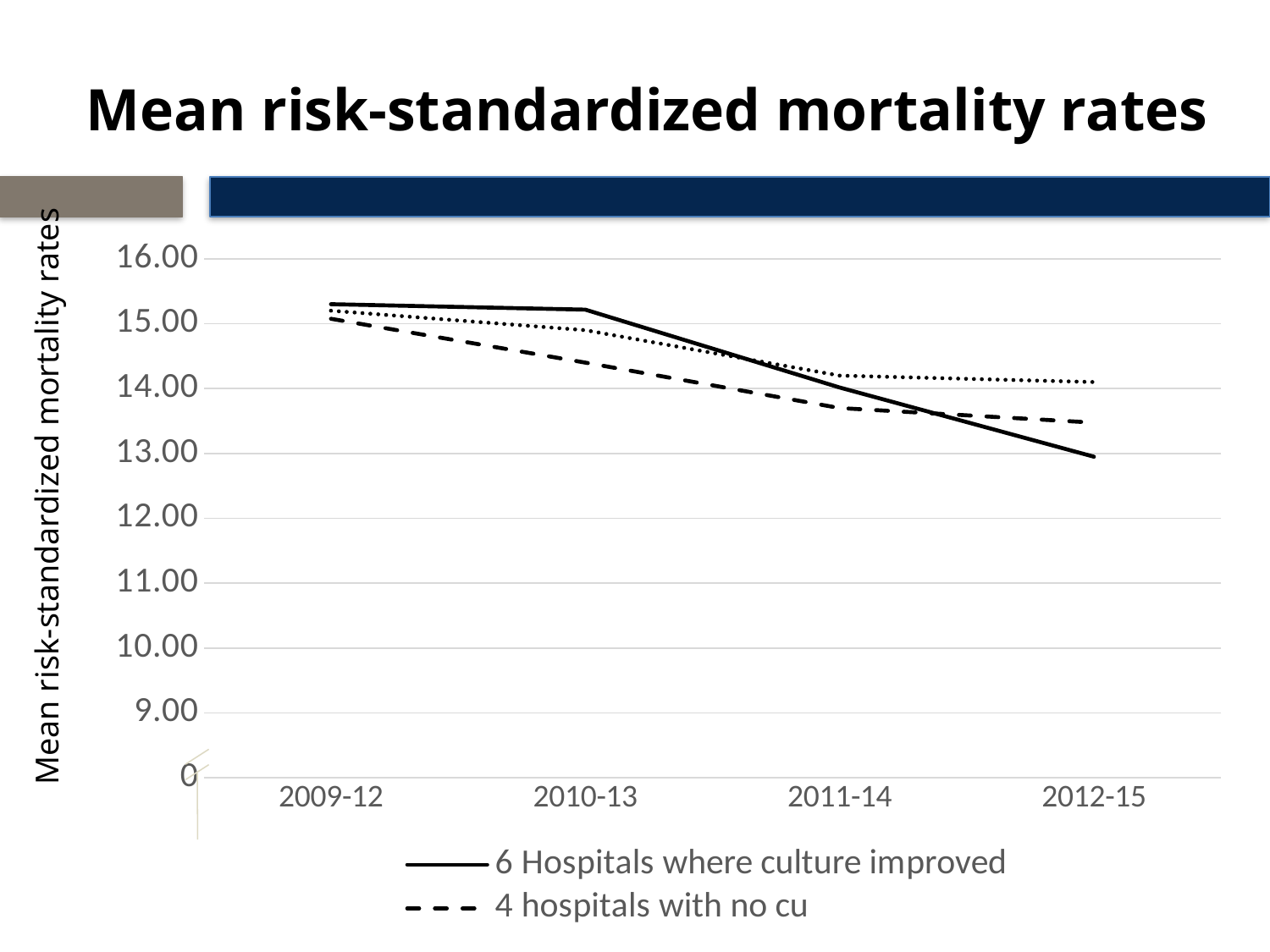
Is the value for '4 hospitals with no cu' in 2012-15 greater or less than 14.00? less How many time periods are shown on the x axis? 4 In 2012-15, which line is higher: '6 Hospitals where culture improved' or '4 hospitals with no cu'? 4 hospitals with no cu How many lines are plotted on the chart? 3 In which period is the value for '6 Hospitals where culture improved' lowest? 2012-15 In 2010-13, which line is higher: '6 Hospitals where culture improved' or '4 hospitals with no cu'? 6 Hospitals where culture improved Does the line for '6 Hospitals where culture improved' rise or fall from 2009-12 to 2012-15? Fall Is the value for '6 Hospitals where culture improved' in 2009-12 greater or less than 15.00? greater What kind of chart is shown on the slide? Line chart Does the dashed line for '4 hospitals with no cu' rise or fall across the periods shown? Fall Is the value for '4 hospitals with no cu' in 2010-13 greater or less than 14.00? greater What is the title of the y axis? Mean risk-standardized mortality rates